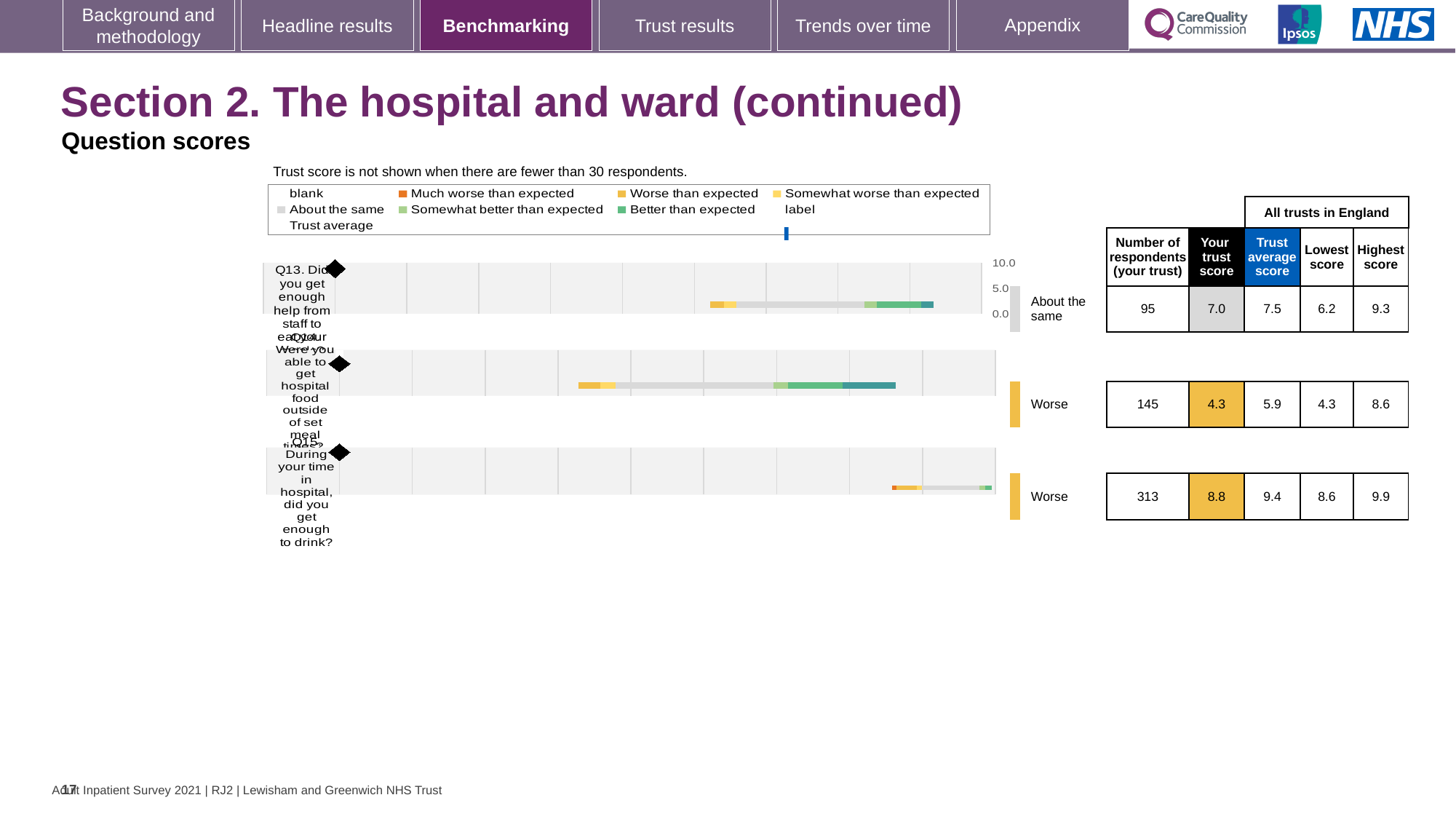
Which question has the highest 'Your trust score' on this slide? Q15 What is the difference between the 'Your trust score' for Q15 and for Q14? 4.5 Which benchmark category is shown next to the Q14 and Q15 charts? Worse What kind of chart is used to show the question scores on this slide? bar chart What is the highest score among all trusts in England for Q13? 9.3 How many respondents from your trust answered Q14 (Were you able to get hospital food outside of set meal times)? 145 What is the 'Your trust score' for Q13 (Did you get enough help from staff to eat your meals)? 7.0 Which question has the lowest 'Your trust score' on this slide? Q14 How many questions (Q13, Q14, Q15) are plotted on the slide? 3 Which benchmark category is shown next to the Q13 chart? About the same For Q13, which is larger: the 'Your trust score' or the trust average score for all trusts in England? Trust average score What is the trust average score across all trusts in England for Q15 (did you get enough to drink)? 9.4